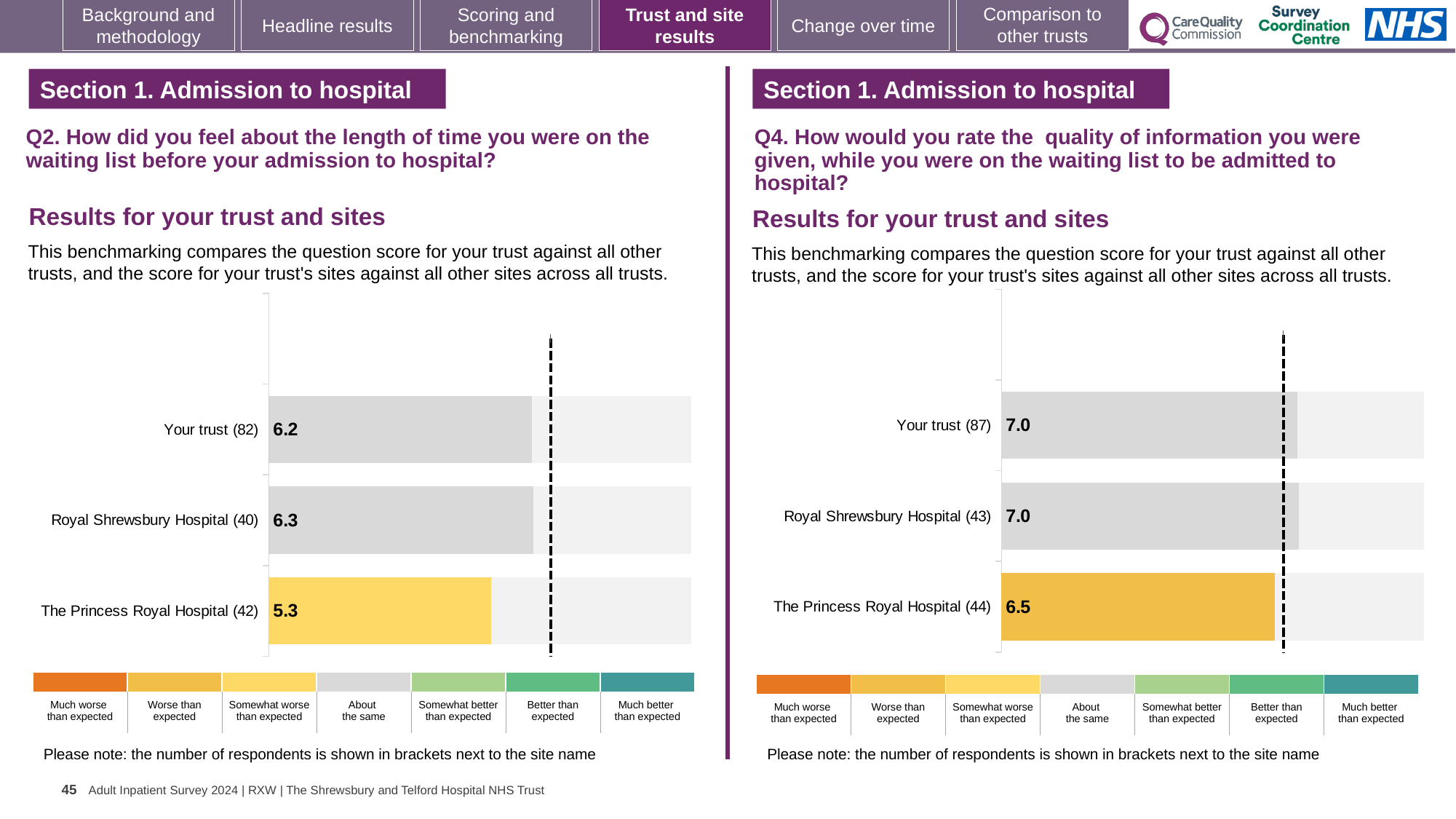
In the Q4 chart on the right, what is the score for The Princess Royal Hospital? 6.5 In the Q4 chart on the right, what is the score for Royal Shrewsbury Hospital? 7.0 In the Q2 chart on the left, what is the score for The Princess Royal Hospital? 5.3 In the Q2 chart on the left, what is the score for Your trust? 6.2 In the Q4 chart on the right, how many respondents are shown in brackets for Your trust? 87 In the Q2 chart on the left, which site or trust has the lowest score? The Princess Royal Hospital In the Q2 chart on the left, which bar is coloured yellow rather than grey? The Princess Royal Hospital In the Q4 chart on the right, which is larger: the score for Your trust or the score for The Princess Royal Hospital? Your trust In the Q4 chart on the right, what is the difference between the scores for Your trust and The Princess Royal Hospital? 0.5 In the Q2 chart on the left, what is the difference between the scores for Royal Shrewsbury Hospital and The Princess Royal Hospital? 1.0 In the Q2 chart on the left, how many bars are plotted? 3 What type of chart is used in the Q2 chart on the left? Bar chart